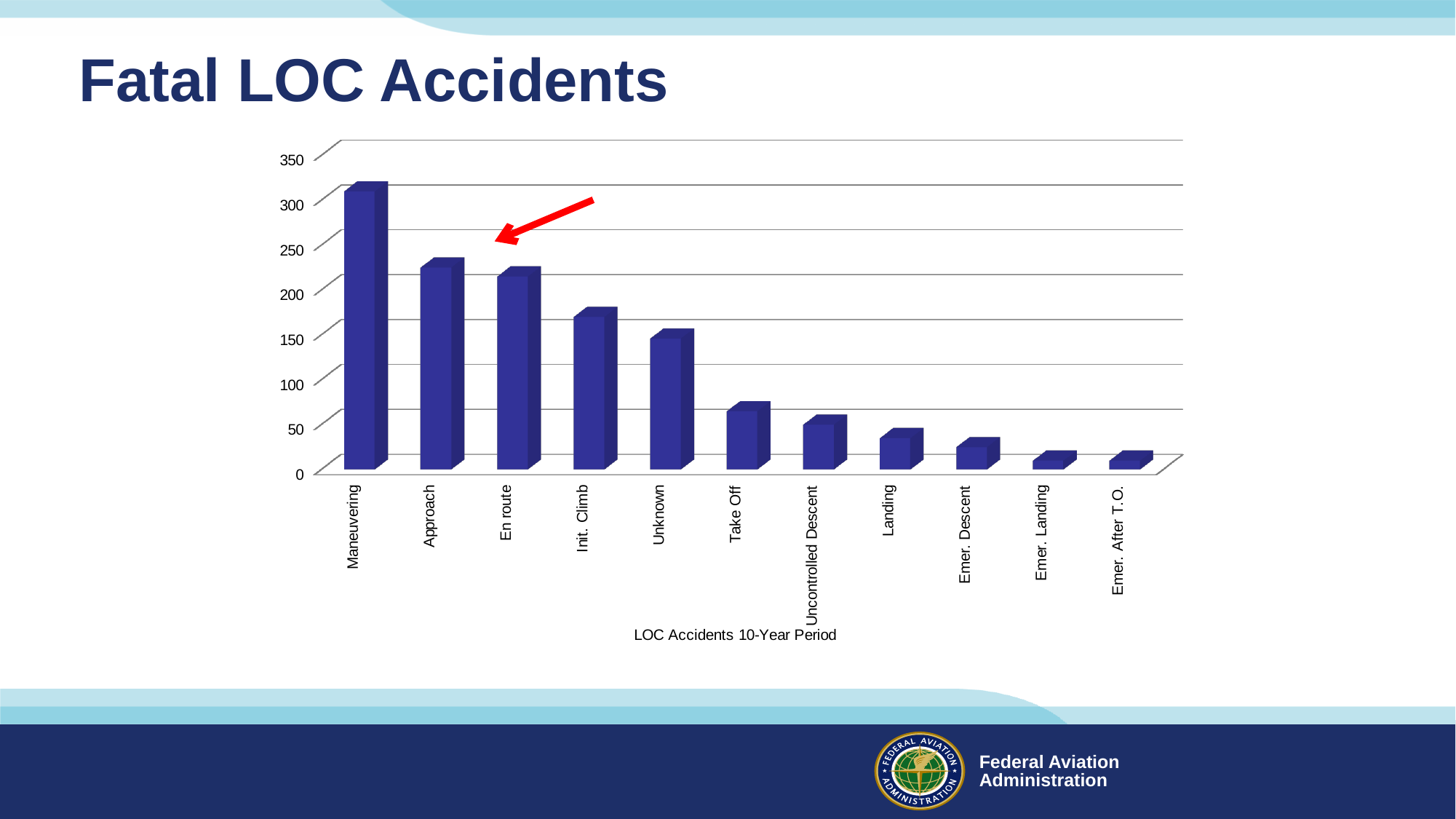
How many categories are plotted on the x axis? 11 Is the value for Maneuvering greater or less than 250? greater Is the value for Landing greater or less than 50? less Is the value for Approach greater or less than 200? greater Do the values rise or fall moving from left to right along the x axis? Fall Which is larger, the value for Approach or the value for Init. Climb? Approach What kind of chart is shown on the slide? Bar chart What is the x-axis title of the chart? LOC Accidents 10-Year Period Which category has the highest number of fatal LOC accidents? Maneuvering